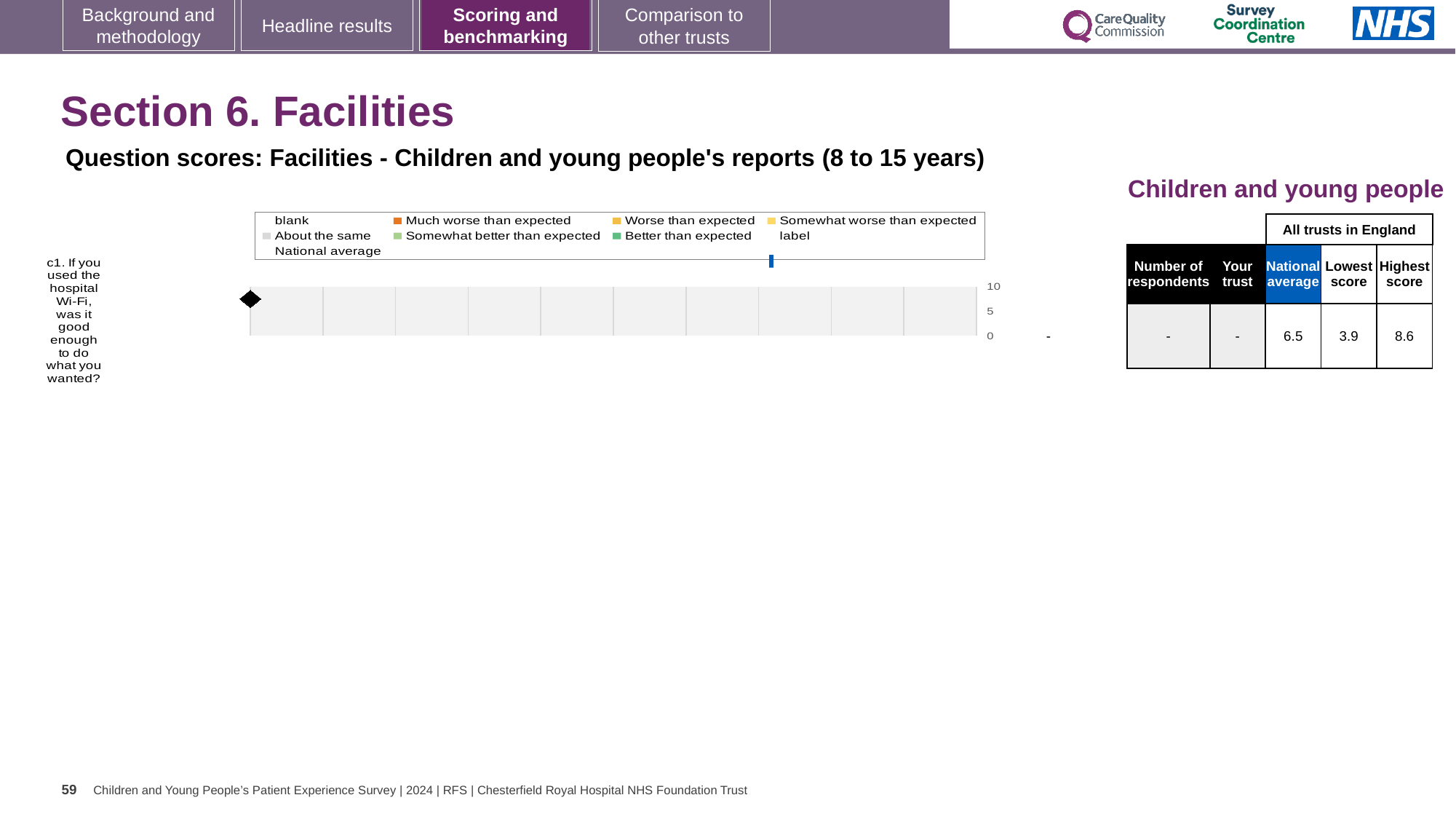
How many survey questions (categories) are plotted on the chart? 1 What kind of chart is used for the question scores? bar chart In the table, what is the Highest score among all trusts in England? 8.6 In the table, what is the National average score for the Wi-Fi question? 6.5 In the table, what is the Lowest score among all trusts in England? 3.9 What is the difference between the Highest score and the Lowest score in the table? 4.7 What is the highest value shown on the chart's vertical axis? 10 Which question is the single category on the chart? c1. If you used the hospital Wi-Fi, was it good enough to do what you wanted? Is the National average score in the table greater or less than 5? greater What value is shown for Your trust in the table? -